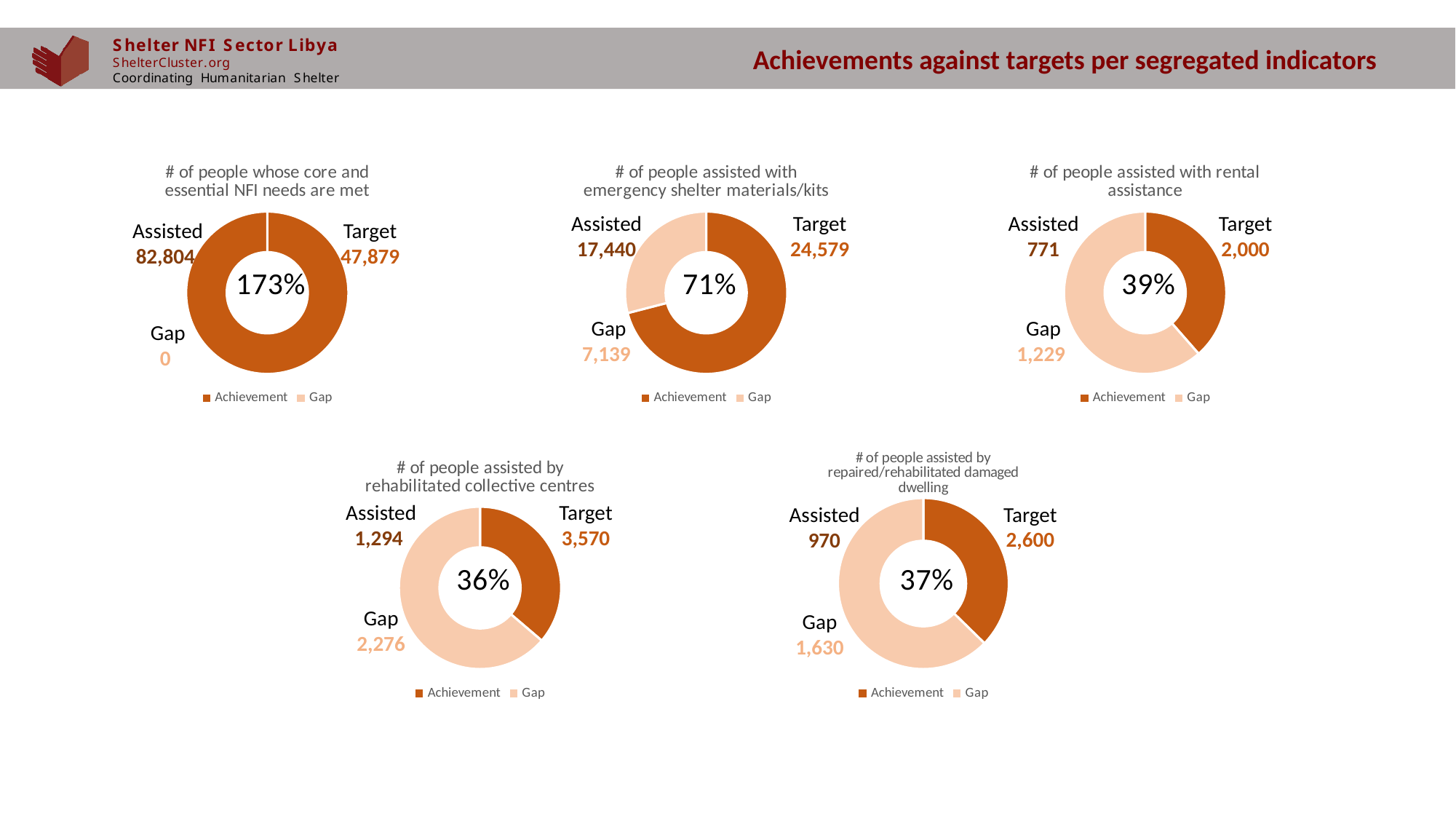
How many entries does the legend of the chart titled "# of people assisted with rental assistance" list? 2 In the chart titled "# of people assisted with rental assistance", which is larger, the Assisted value or the Gap value? Gap How many donut charts are shown on the slide? 5 In the chart titled "# of people whose core and essential NFI needs are met", what is the Assisted value? 82,804 In the chart titled "# of people assisted with emergency shelter materials/kits", what is the difference between the Target and the Assisted values? 7,139 Which of the five charts shows the lowest achievement percentage in its centre? # of people assisted by rehabilitated collective centres In the chart titled "# of people assisted by repaired/rehabilitated damaged dwelling", what is the Assisted value? 970 In the chart titled "# of people assisted with rental assistance", what is the Gap value? 1,229 What type of chart is used for "# of people assisted by repaired/rehabilitated damaged dwelling"? Donut chart In the chart titled "# of people assisted with emergency shelter materials/kits", what is the Target value? 24,579 In the chart titled "# of people assisted by rehabilitated collective centres", what percentage is shown in the centre of the donut? 36% Which of the five charts shows the highest achievement percentage in its centre? # of people whose core and essential NFI needs are met